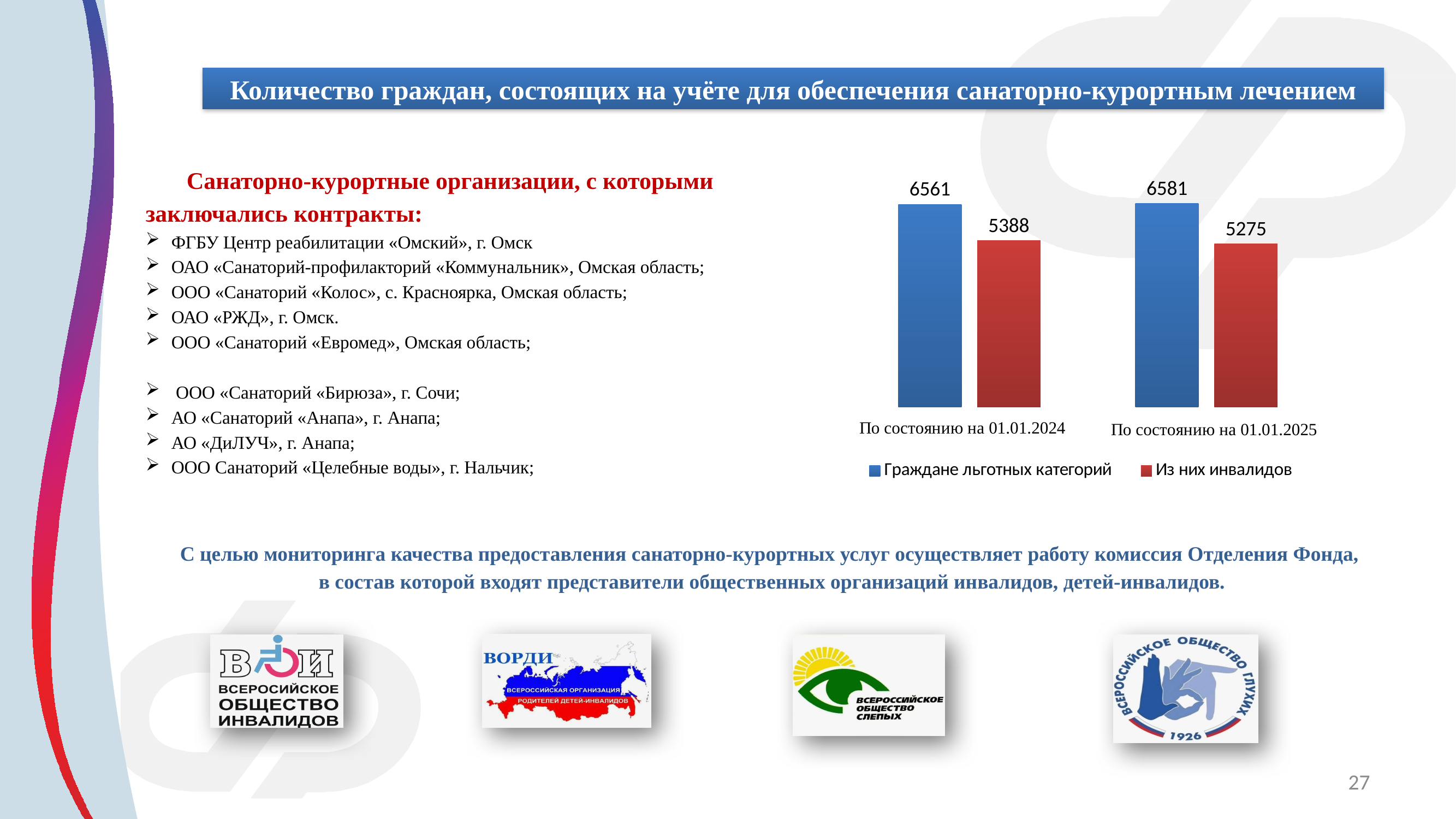
Which bar has the highest value on the chart? Граждане льготных категорий, 01.01.2025 (6581) What kind of chart is shown on the slide? bar chart Which is larger: "Из них инвалидов" as of 01.01.2024 or as of 01.01.2025? 01.01.2024 What is the value for "Граждане льготных категорий" as of 01.01.2025? 6581 What is the value for "Граждане льготных категорий" as of 01.01.2024 (По состоянию на 01.01.2024)? 6561 How many series does the legend list? 2 What is the difference between "Граждане льготных категорий" and "Из них инвалидов" as of 01.01.2024? 1173 What is the value for "Из них инвалидов" as of 01.01.2024? 5388 By how much did "Из них инвалидов" change from 01.01.2024 to 01.01.2025? decreased by 113 What is the difference between "Граждане льготных категорий" and "Из них инвалидов" as of 01.01.2025? 1306 What is the value for "Из них инвалидов" as of 01.01.2025 (По состоянию на 01.01.2025)? 5275 Which bar has the lowest value on the chart? Из них инвалидов, 01.01.2025 (5275)